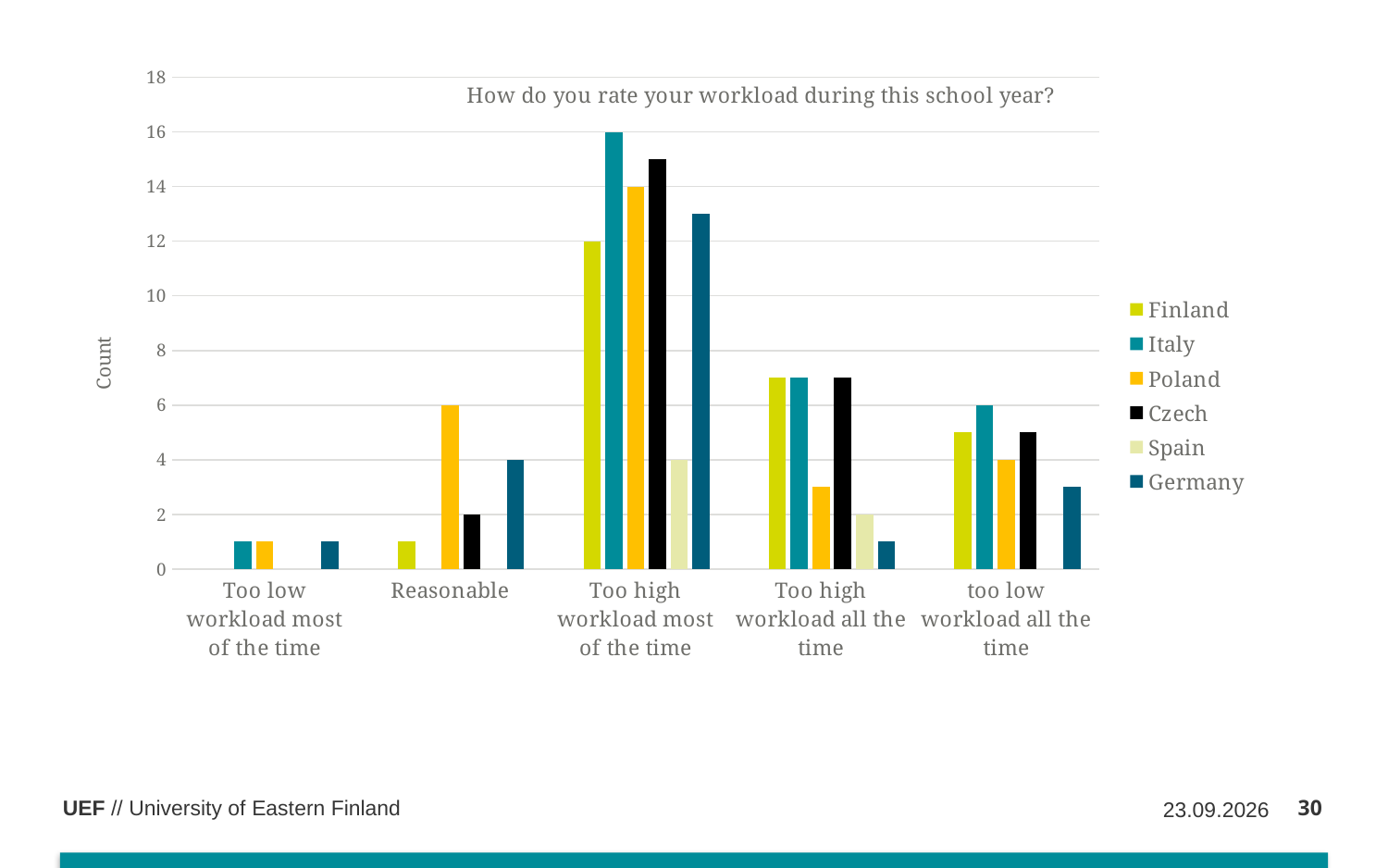
What is the count for Italy in the 'Too high workload most of the time' category? 16 What is the count for Poland in the 'Too high workload most of the time' category? 14 What is the count for Poland in the 'Reasonable' category? 6 Which country has the highest count in the 'Too high workload most of the time' category? Italy How many series does the legend list? 6 How many categories are shown on the x axis? 5 Is the count for Czech in the 'Too high workload all the time' category greater or less than 6? greater What type of chart is shown on the slide? bar chart Which is larger in the 'too low workload all the time' category, the count for Italy or the count for Germany? Italy What is the difference between Italy's and Finland's counts in the 'Too high workload most of the time' category? 4 Which country has the lowest count in the 'Too high workload most of the time' category? Spain What is the title of the chart? How do you rate your workload during this school year?